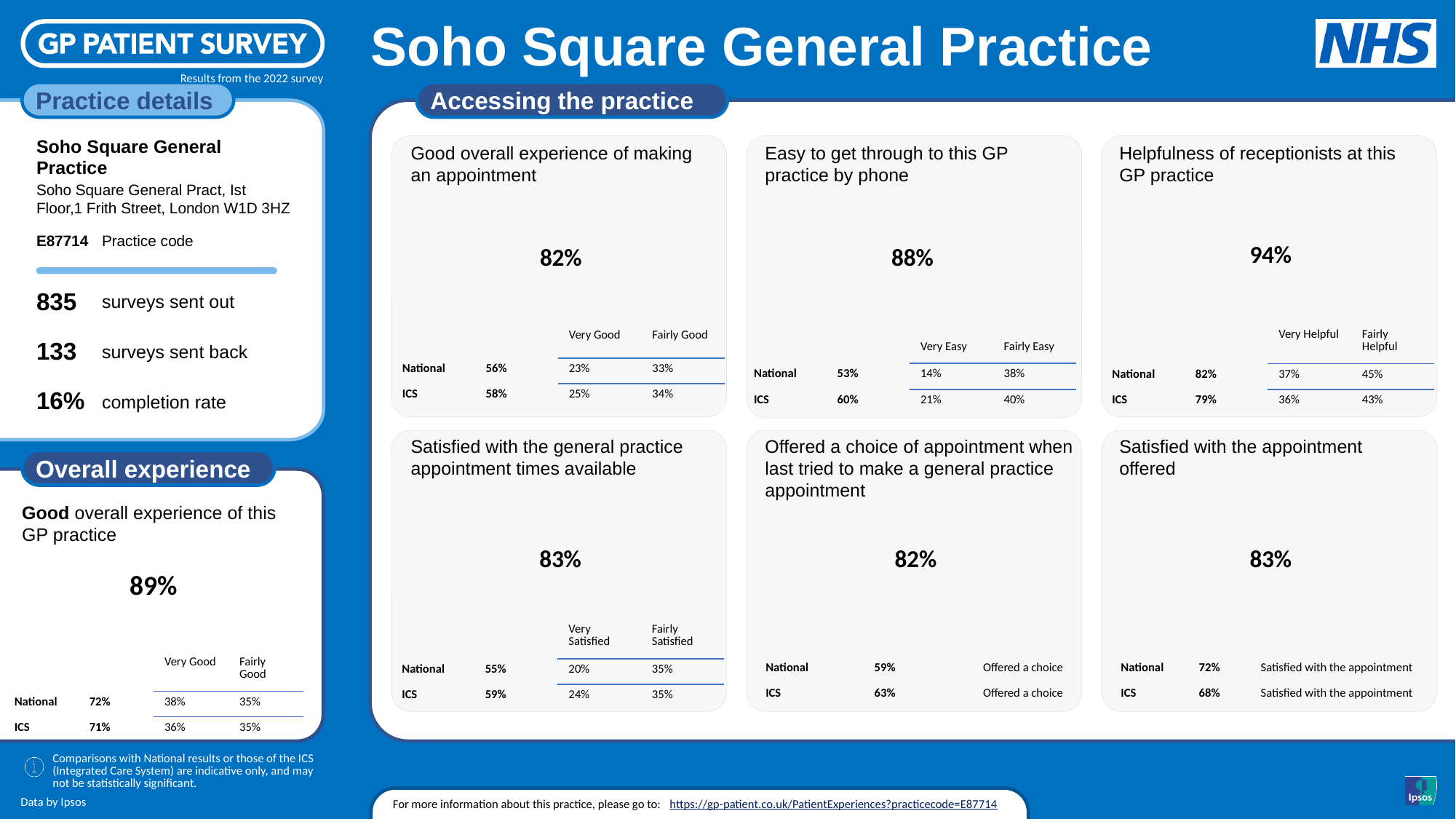
In the 'Easy to get through to this GP practice by phone' panel, what is the difference between the practice's percentage and the ICS percentage? 28% In the 'Good overall experience of making an appointment' panel, what is the practice's headline percentage? 82% In the 'Overall experience' section, what is the practice's percentage for good overall experience of this GP practice? 89% In the 'Satisfied with the general practice appointment times available' panel, what is the ICS 'Very Satisfied' percentage? 24% In the 'Offered a choice of appointment when last tried to make a general practice appointment' panel, which is larger: the National percentage or the ICS percentage? ICS In the 'Overall experience' section, what is the National 'Fairly Good' percentage? 35% Across the six 'Accessing the practice' panels, which measure has the highest practice headline percentage? Helpfulness of receptionists at this GP practice In the 'Helpfulness of receptionists at this GP practice' panel, what is the ICS 'Very Helpful' percentage? 36% In the 'Easy to get through to this GP practice by phone' panel, what is the National percentage? 53% In the 'Satisfied with the appointment offered' panel, what is the difference between the practice's percentage and the National percentage? 11% What is the completion rate shown in the 'Practice details' section? 16% How many measure panels are shown in the 'Accessing the practice' section? 6